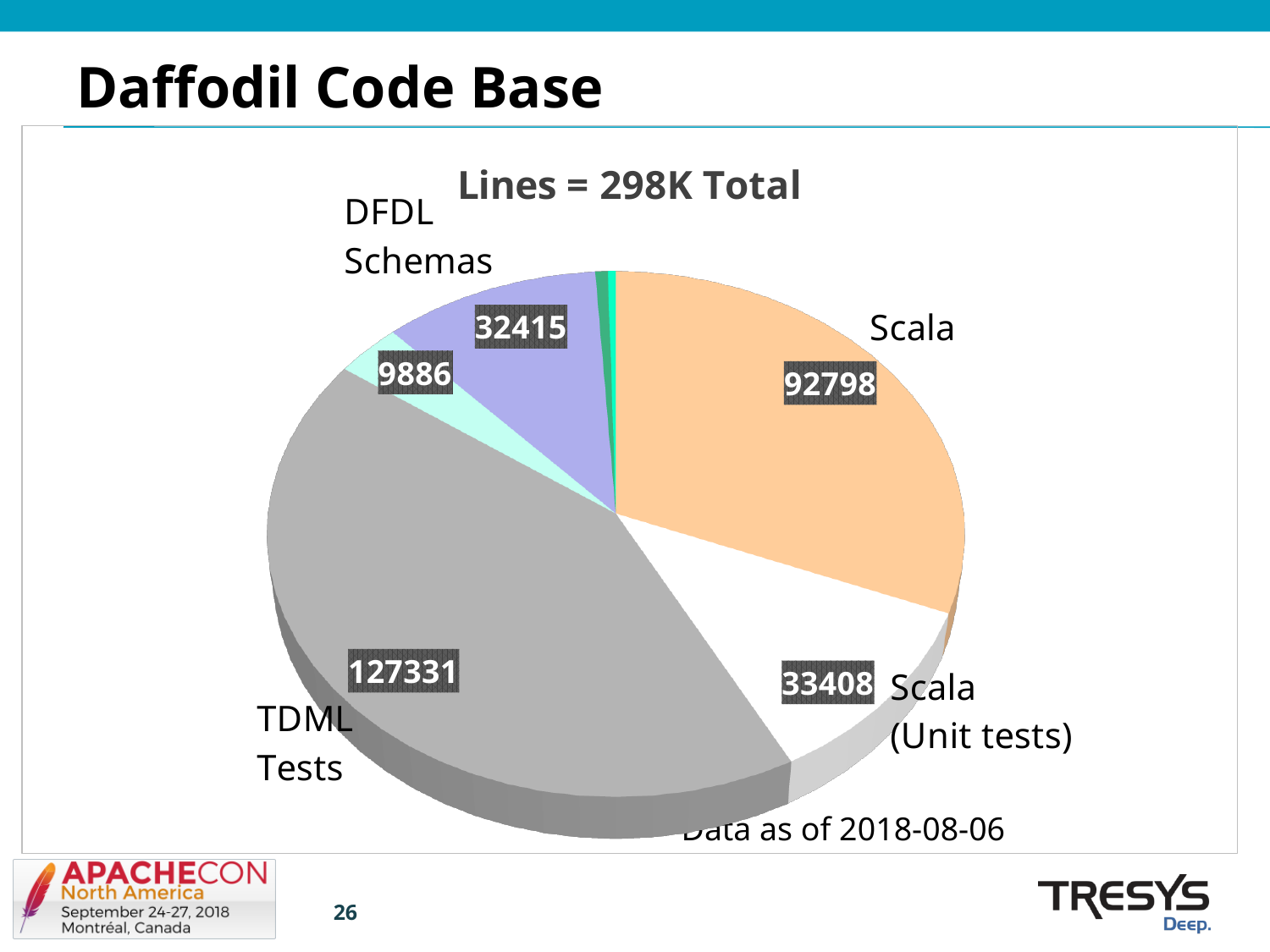
What is the difference between the TDML Tests value and the Scala value? 34533 What is the value shown for Scala (Unit tests)? 33408 Which labelled category has the largest slice of the pie? TDML Tests What is the difference between the Scala value and the Scala (Unit tests) value? 59390 What is the value shown for TDML Tests? 127331 Which is larger, the Scala slice or the Scala (Unit tests) slice? Scala As of what date is the chart's data, according to the note on the slide? 2018-08-06 What is the title of the pie chart? Lines = 298K Total How many lines does the Scala slice represent? 92798 What kind of chart is shown on the slide? pie chart